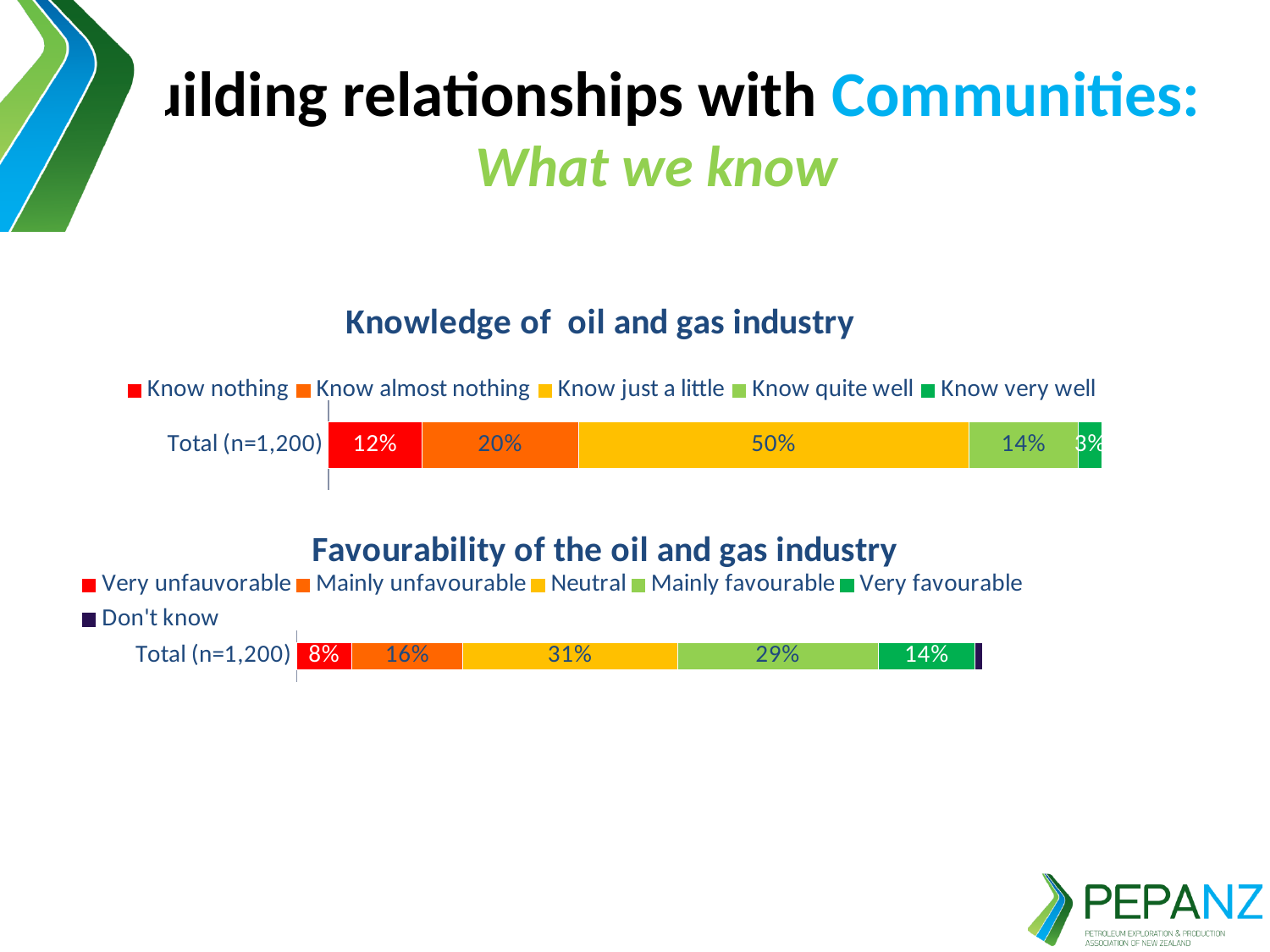
How many categories does the legend of the 'Favourability of the oil and gas industry' chart list? 6 What type of chart is the 'Favourability of the oil and gas industry' chart? Stacked bar chart In the 'Knowledge of oil and gas industry' chart, what percentage of respondents 'Know nothing'? 12% In the 'Knowledge of oil and gas industry' chart, what percentage of respondents 'Know just a little'? 50% In the 'Favourability of the oil and gas industry' chart, which is larger: 'Mainly unfavourable' or 'Very favourable'? Mainly unfavourable How many categories does the legend of the 'Knowledge of oil and gas industry' chart list? 5 In the 'Favourability of the oil and gas industry' chart, what percentage of respondents are 'Neutral'? 31% What sample size is shown for the 'Total' bar in the 'Knowledge of oil and gas industry' chart? n=1,200 In the 'Knowledge of oil and gas industry' chart, which category has the largest share? Know just a little In the 'Favourability of the oil and gas industry' chart, what percentage of respondents are 'Mainly favourable'? 29% In the 'Knowledge of oil and gas industry' chart, what is the difference between 'Know almost nothing' and 'Know quite well'? 6 percentage points In the 'Favourability of the oil and gas industry' chart, what is the difference between 'Neutral' and 'Very unfauvorable'? 23 percentage points